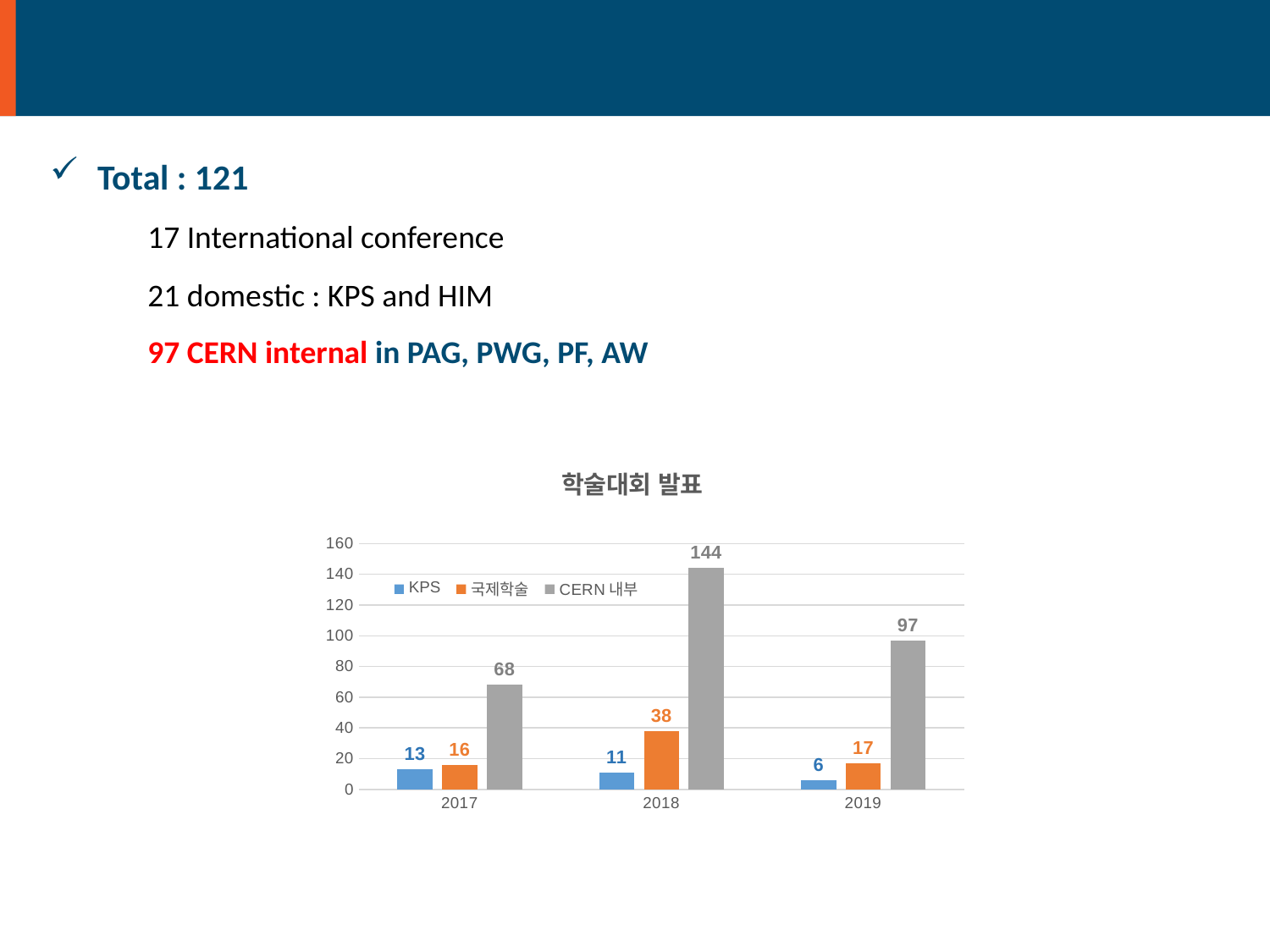
Which year has the highest value for CERN 내부? 2018 Which year has the lowest value for KPS? 2019 What kind of chart is shown on the slide? bar chart What is the value for CERN 내부 in 2018? 144 What is the difference between the CERN 내부 values for 2018 and 2019? 47 Is the value for CERN 내부 in 2017 greater or less than 60? greater What is the value for 국제학술 in 2019? 17 How many years are shown on the x axis? 3 Which is larger, the 국제학술 value for 2018 or for 2017? 2018 What is the value for KPS in 2017? 13 How many series does the legend list? 3 What is the title of the chart? 학술대회 발표